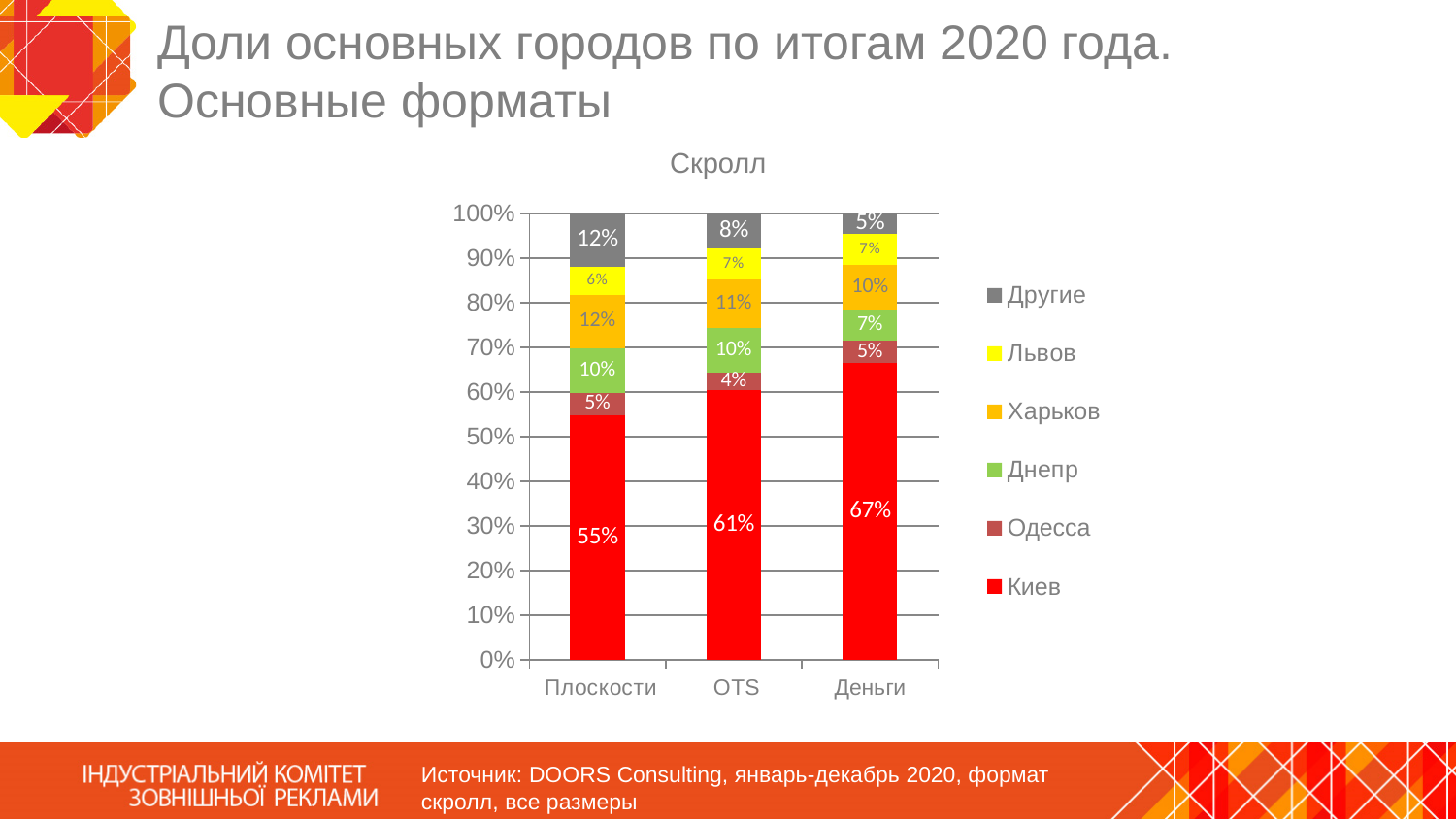
How many series does the legend list? 6 What is the share of Киев for Плоскости? 55% How many categories are shown on the x axis? 3 What is the difference between the Киев share for Деньги and for Плоскости? 12% In which category does Киев have the highest share? Деньги What type of chart is shown? Stacked bar chart What is the share of Киев for Деньги? 67% What is the share of Харьков for Плоскости? 12% Which is larger: the Днепр share for OTS or for Деньги? OTS What is the share of Одесса for OTS? 4% What is the share of Другие for OTS? 8% In which category does Другие have the lowest share? Деньги